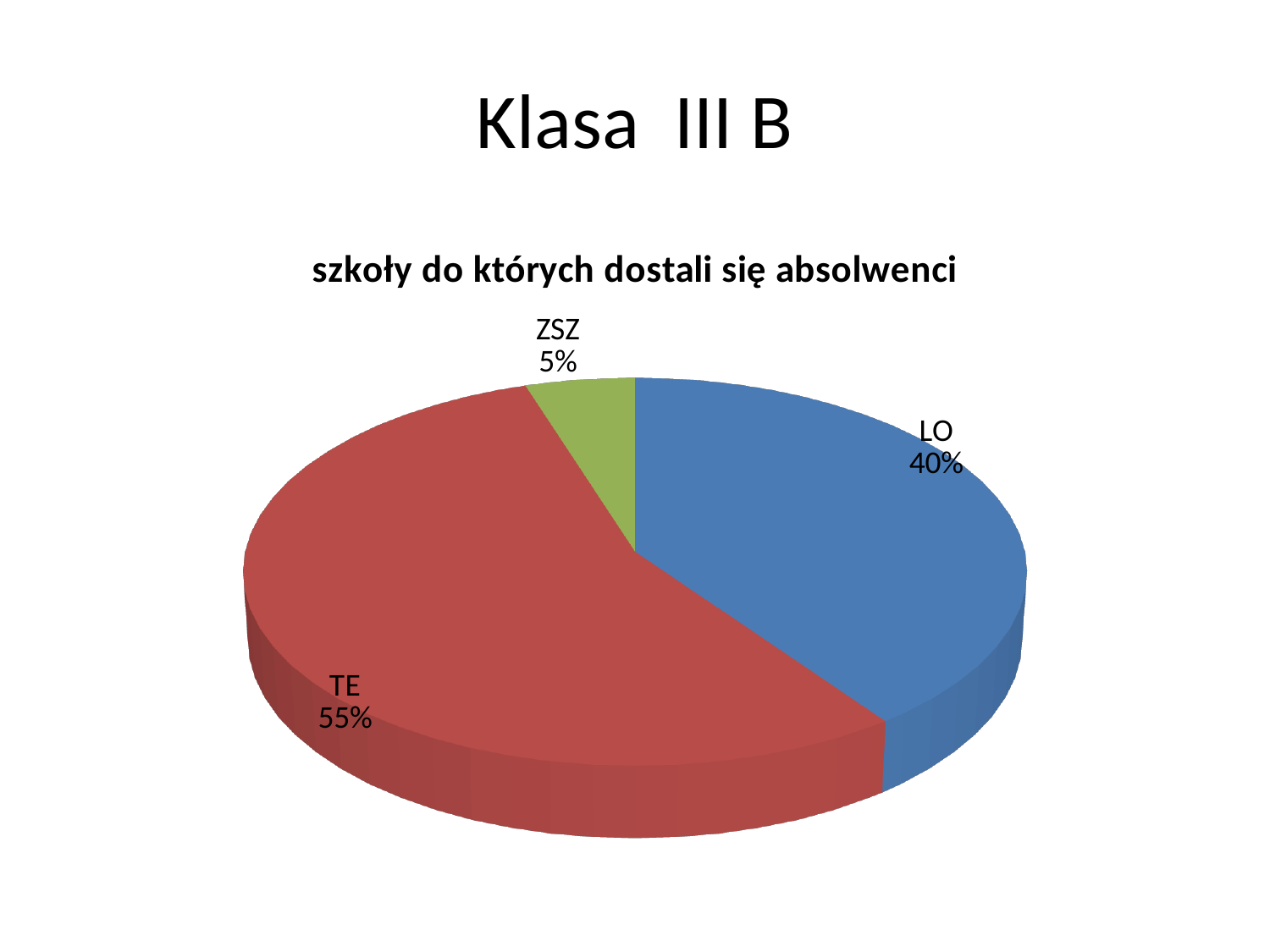
What is the difference in percentage points between LO and ZSZ? 35 Which category has the smallest slice of the pie? ZSZ What is the title of the chart? szkoły do których dostali się absolwenci What kind of chart is shown on the slide? pie chart What share of the pie does ZSZ represent? 5% What is the difference in percentage points between TE and LO? 15 Which is larger, the share for LO or the share for TE? TE What share of the pie does TE represent? 55% How many categories are shown in the pie chart? 3 What colour is the slice for TE? red Which category has the largest slice of the pie? TE What share of the pie does LO represent? 40%